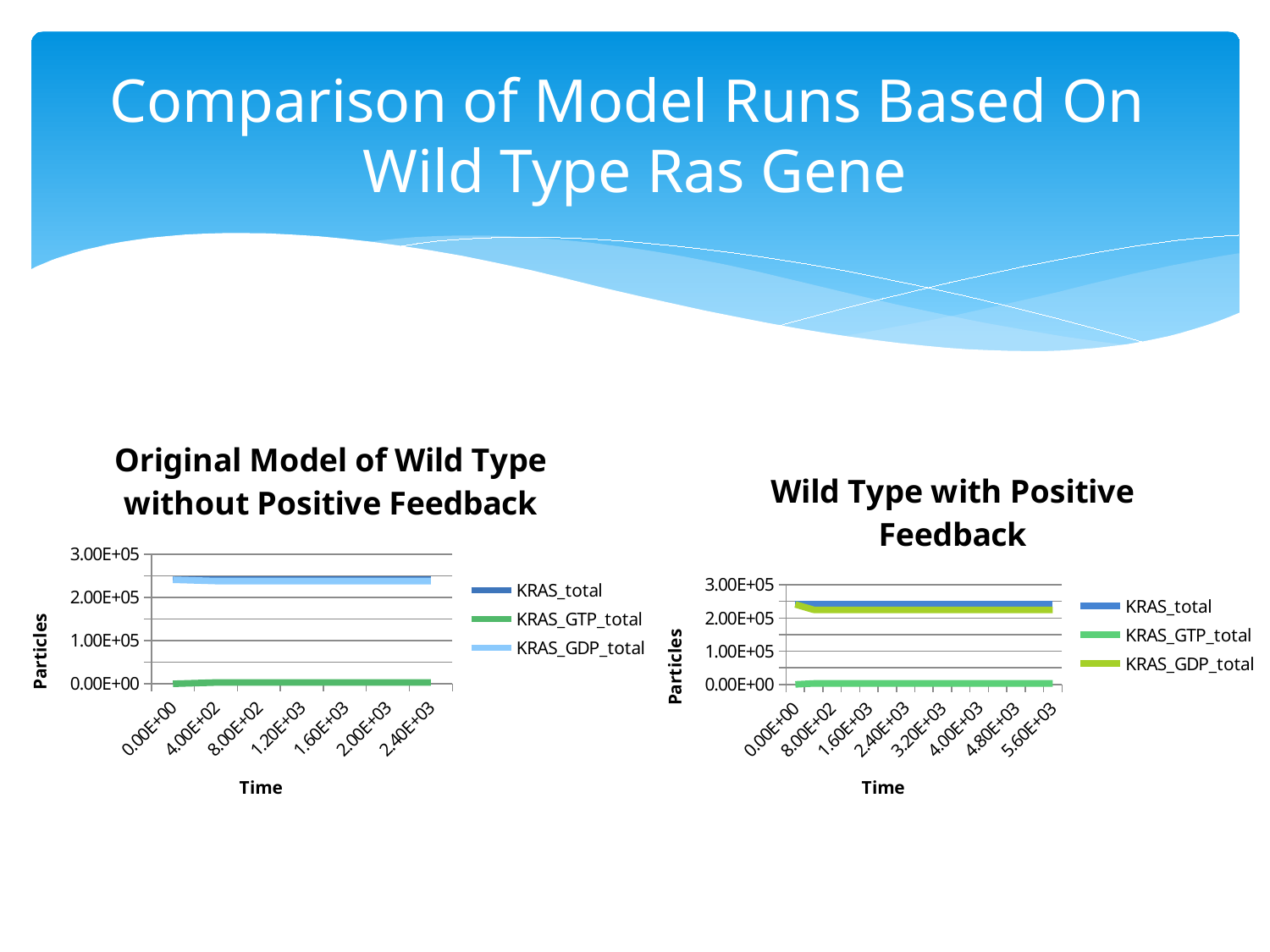
What kind of chart is the "Wild Type with Positive Feedback" chart? line chart How many series does the legend of the "Wild Type with Positive Feedback" chart list? 3 In the "Wild Type with Positive Feedback" chart, is the value for KRAS_GDP_total greater or less than 1.00E+05? greater In the "Original Model of Wild Type without Positive Feedback" chart, which series has the lowest values? KRAS_GTP_total How many series does the legend of the "Original Model of Wild Type without Positive Feedback" chart list? 3 In the "Original Model of Wild Type without Positive Feedback" chart, which is larger, KRAS_GTP_total or KRAS_GDP_total? KRAS_GDP_total What kind of chart is the "Original Model of Wild Type without Positive Feedback" chart? line chart In the "Wild Type with Positive Feedback" chart, which is larger, KRAS_GDP_total or KRAS_GTP_total? KRAS_GDP_total What is the label of the y axis on the "Wild Type with Positive Feedback" chart? Particles In the "Wild Type with Positive Feedback" chart, is the value for KRAS_GTP_total greater or less than 1.00E+05? less In the "Original Model of Wild Type without Positive Feedback" chart, is the value for KRAS_GDP_total greater or less than 2.00E+05? greater What is the label of the x axis on the "Original Model of Wild Type without Positive Feedback" chart? Time